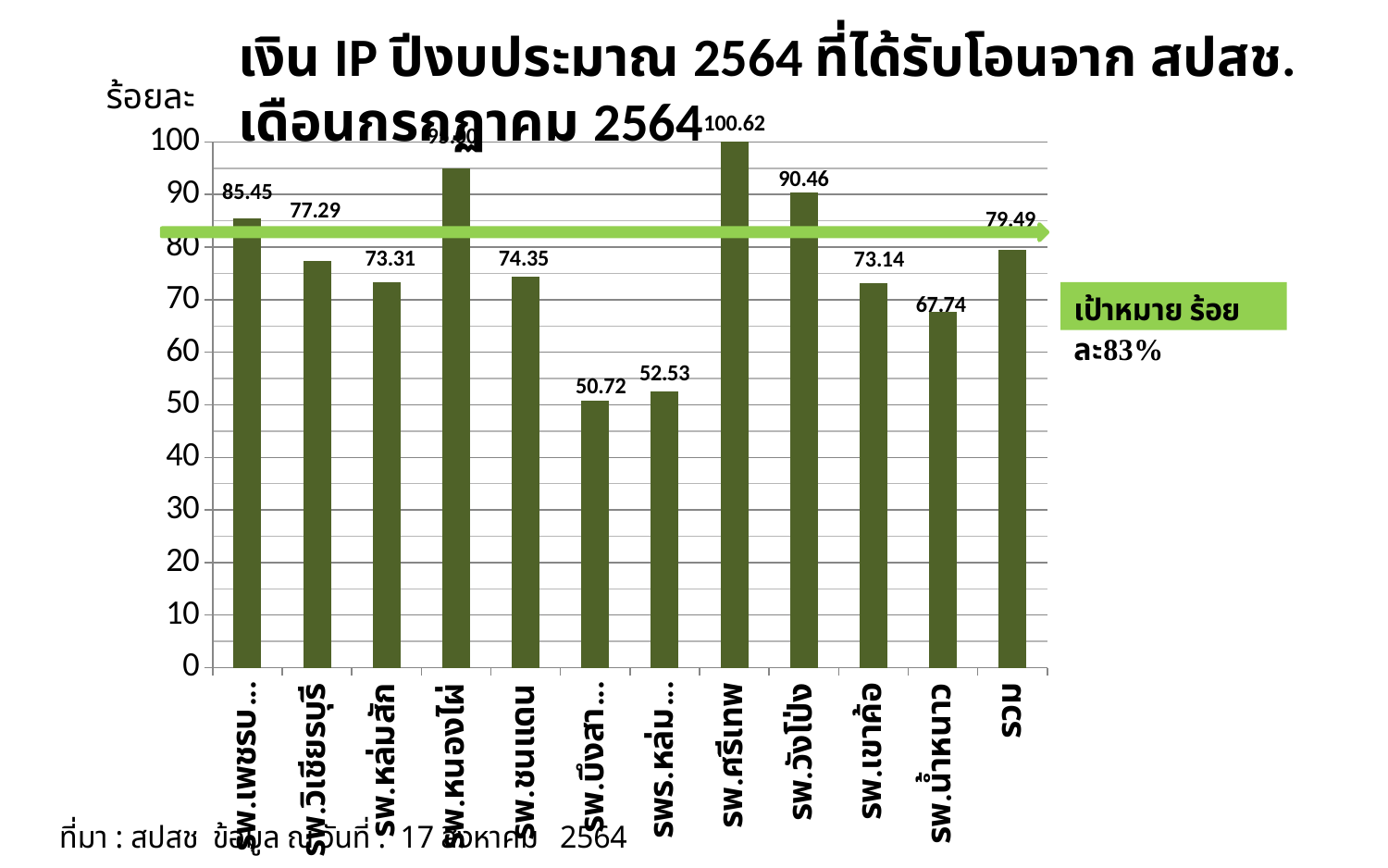
What is the value for รพ.น้ำหนาว? 67.74 Which category has the highest value? รพ.ศรีเทพ What type of chart is shown on the slide? bar chart What is the value for รพ.วิเชียรบุรี? 77.29 What is the value for รพ.วังโป่ง? 90.46 What is the value for รพ.ศรีเทพ? 100.62 What is the value for รวม? 79.49 What target percentage is indicated by the horizontal line on the chart? 83% What is the difference between the values for รพ.ศรีเทพ and รพ.วังโป่ง? 10.16 What is the lowest value shown in the chart? 50.72 How many bars (categories) are plotted in the chart? 12 Which is larger, the value for รพ.วังโป่ง or the value for รวม? รพ.วังโป่ง